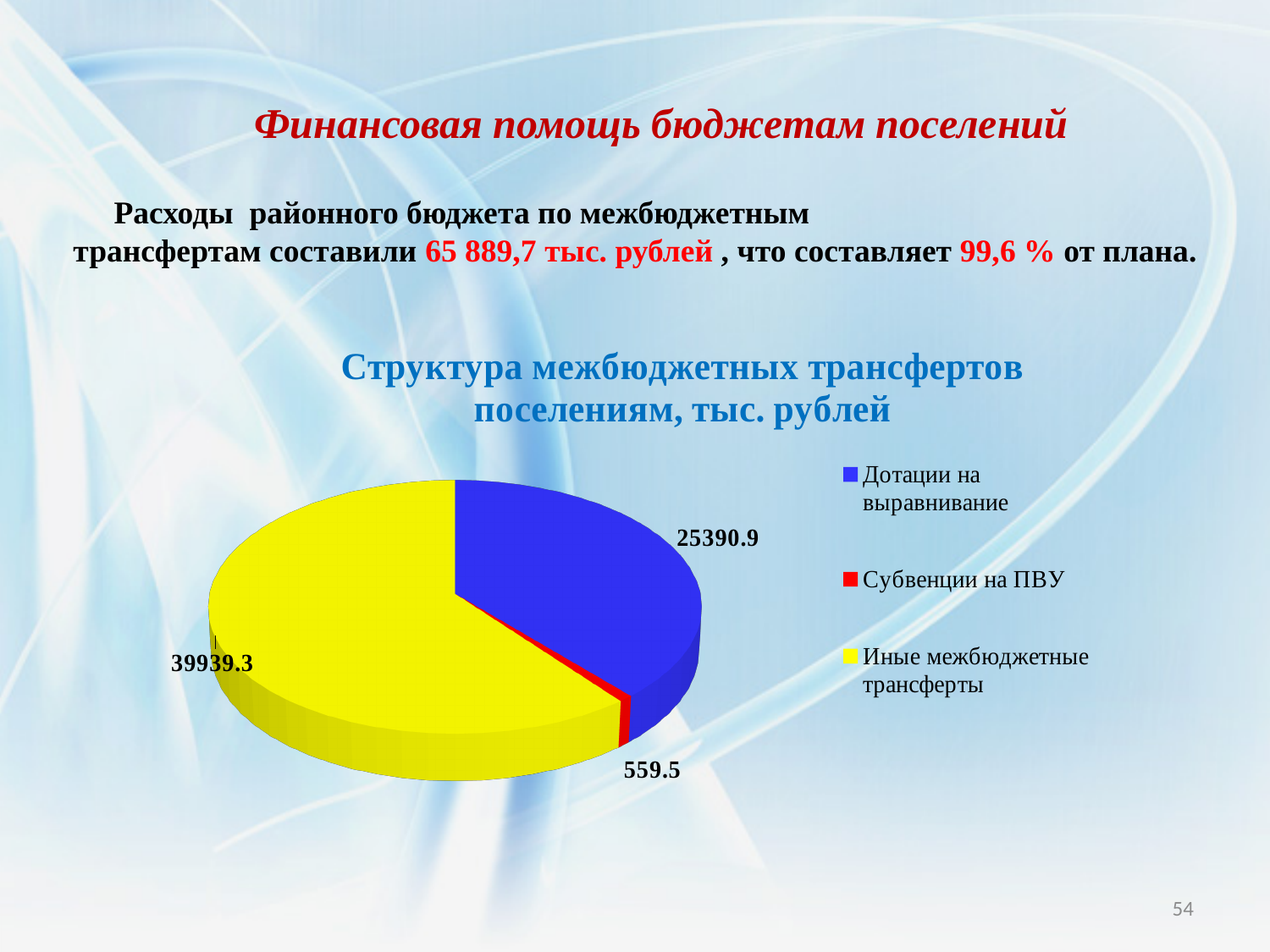
What is the value for Иные межбюджетные трансферты in the pie chart? 39939.3 What is the value for Дотации на выравнивание in the pie chart? 25390.9 What type of chart is shown on the slide? pie chart What is the total of all slices in the pie chart? 65889.7 What is the value for Субвенции на ПВУ in the pie chart? 559.5 Which category has the smallest slice in the pie chart? Субвенции на ПВУ Which is larger: Дотации на выравнивание or Субвенции на ПВУ? Дотации на выравнивание What colour is the slice for Иные межбюджетные трансферты? yellow How many slices does the pie chart have? 3 How many entries does the legend of the pie chart list? 3 Which category has the largest slice in the pie chart? Иные межбюджетные трансферты What is the difference between the values for Иные межбюджетные трансферты and Дотации на выравнивание? 14548.4